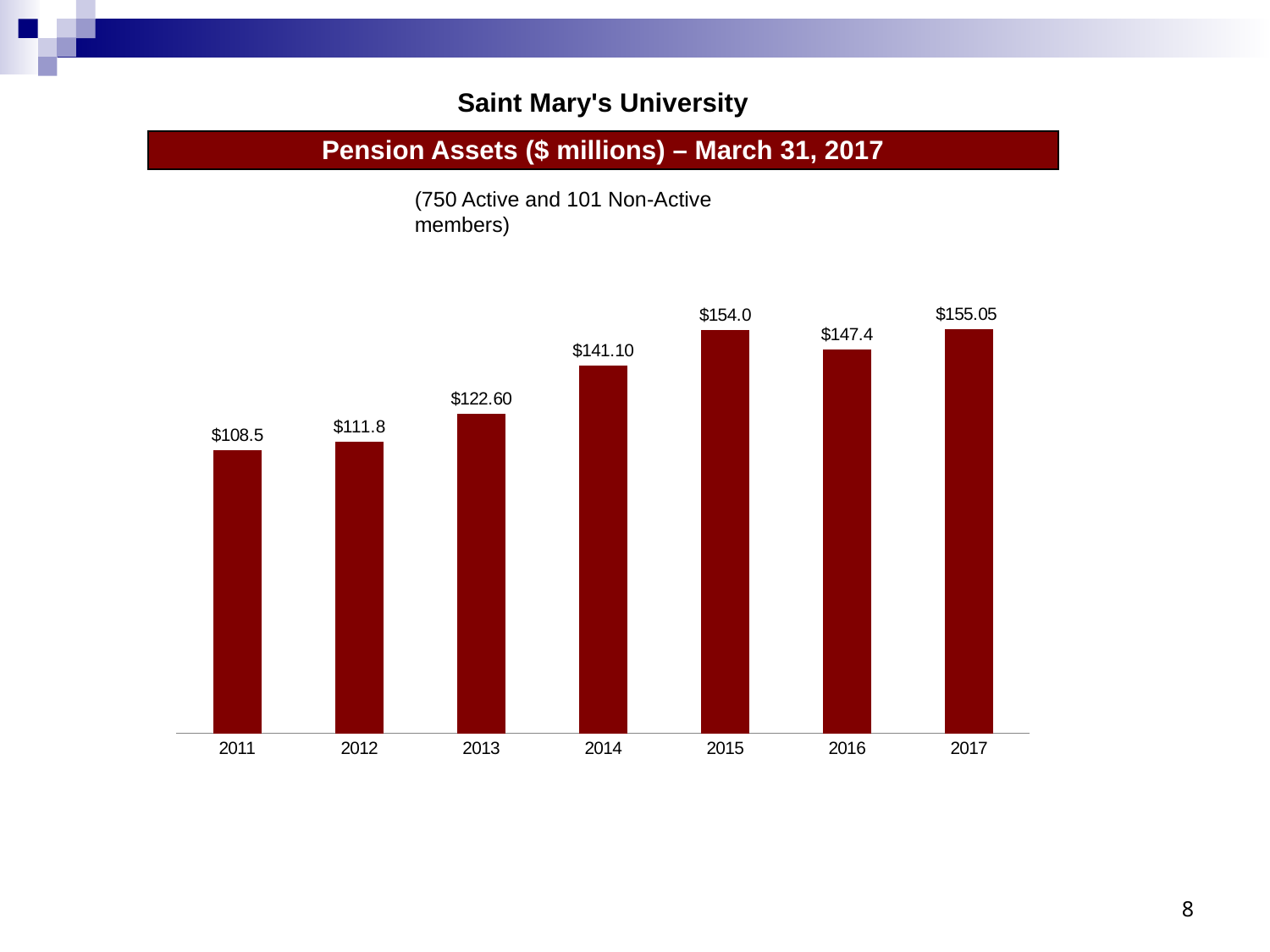
What is the title of the chart? Pension Assets ($ millions) – March 31, 2017 What is the pension assets value for 2014? $141.10 How many years are shown on the chart? 7 Do the pension assets values generally rise or fall from 2011 to 2017? Rise Which year has the highest pension assets value? 2017 What is the difference between the pension assets values for 2015 and 2016? $6.6 What is the difference between the pension assets values for 2013 and 2012? $10.80 What is the pension assets value for 2016? $147.4 What kind of chart is shown on the slide? Bar chart What is the pension assets value for 2011? $108.5 Which year has a larger pension assets value, 2015 or 2016? 2015 Which year has the lowest pension assets value? 2011